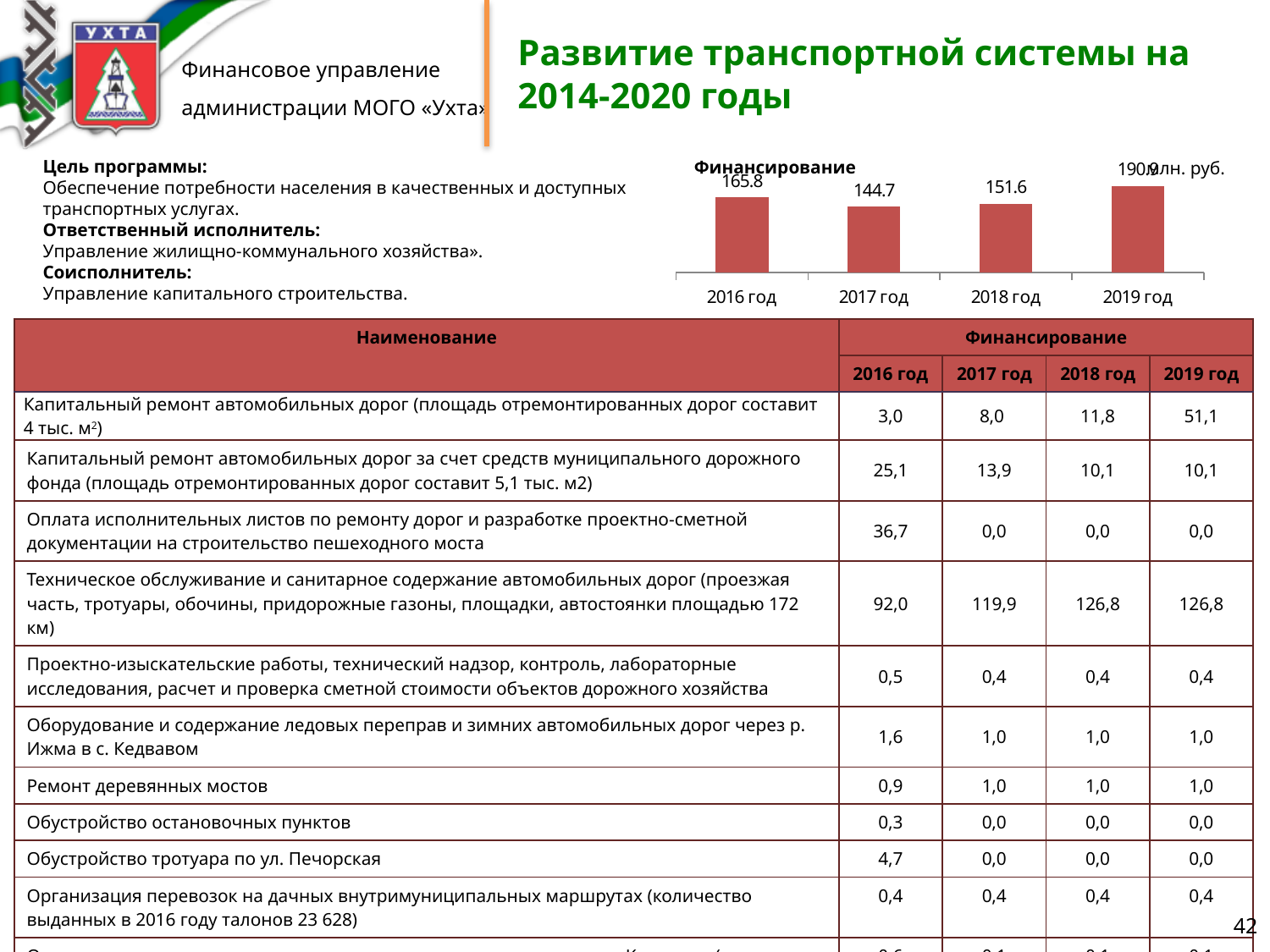
What is the difference between the values for 2018 год and 2017 год in the Финансирование chart? 6.9 Which year has the highest bar in the Финансирование chart? 2019 год What is the difference between the values for 2016 год and 2017 год in the Финансирование chart? 21.1 What is the value for 2017 год in the Финансирование chart? 144.7 What unit is indicated for the values in the Финансирование chart? млн. руб. Which year has the lowest bar in the Финансирование chart? 2017 год What kind of chart is the Финансирование chart? bar chart In the Финансирование chart, does the value rise or fall from 2016 год to 2017 год? fall In the Финансирование chart, which is larger: the value for 2016 год or 2018 год? 2016 год What is the value for 2018 год in the Финансирование chart? 151.6 How many bars are shown in the Финансирование chart? 4 What is the value for 2016 год in the Финансирование chart? 165.8